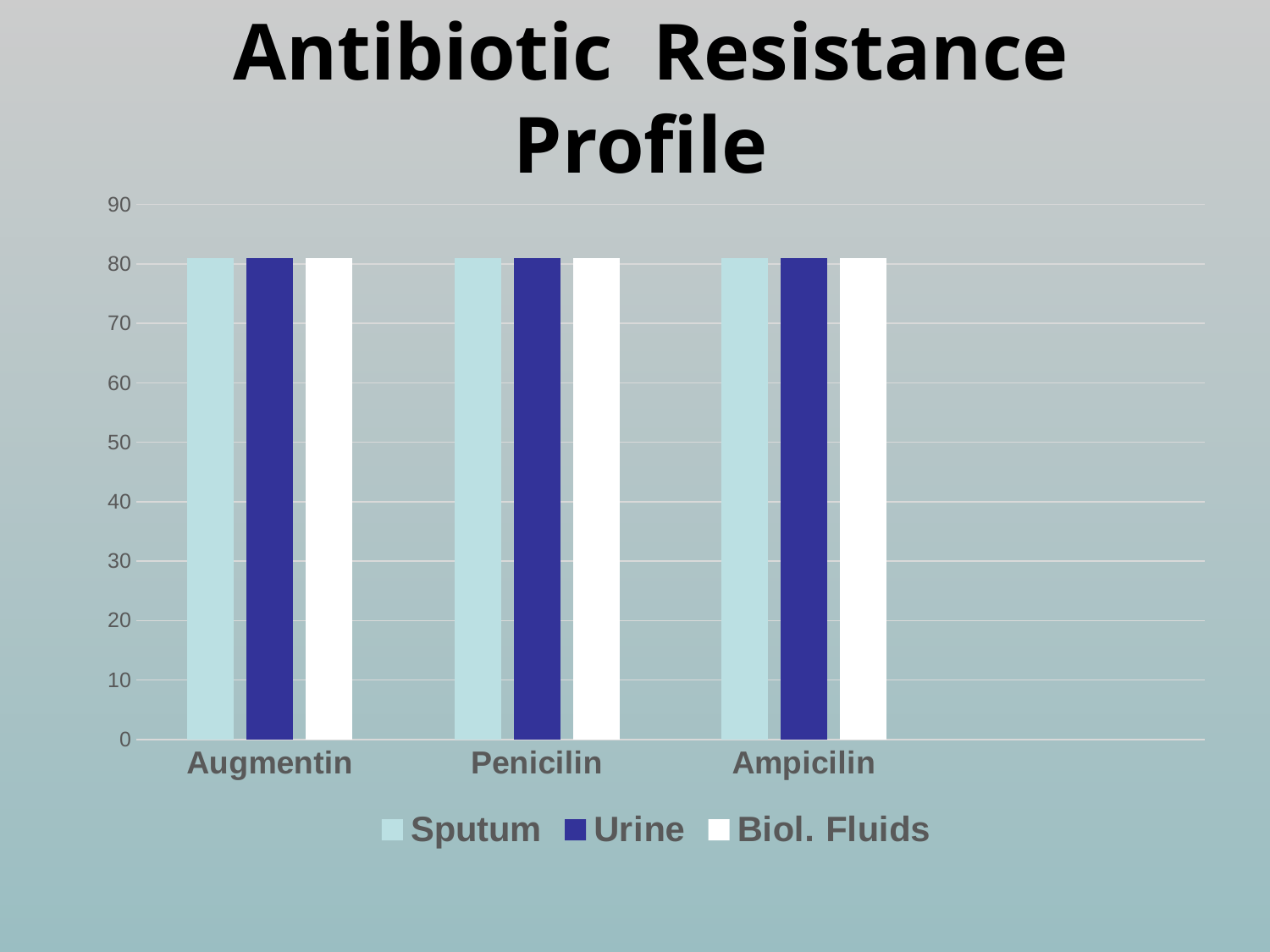
Is the Biol. Fluids value for Ampicilin greater or less than 60? greater Is the Sputum value for Augmentin greater or less than 70? greater How many series does the legend list? 3 Which series is shown in dark blue in the legend? Urine Is the Urine value for Ampicilin greater or less than 90? less Do the Sputum values rise, fall, or stay flat across Augmentin, Penicilin and Ampicilin? stay flat What is the title of the chart? Antibiotic Resistance Profile What kind of chart is shown on the slide? bar chart How many antibiotic categories are shown on the x axis? 3